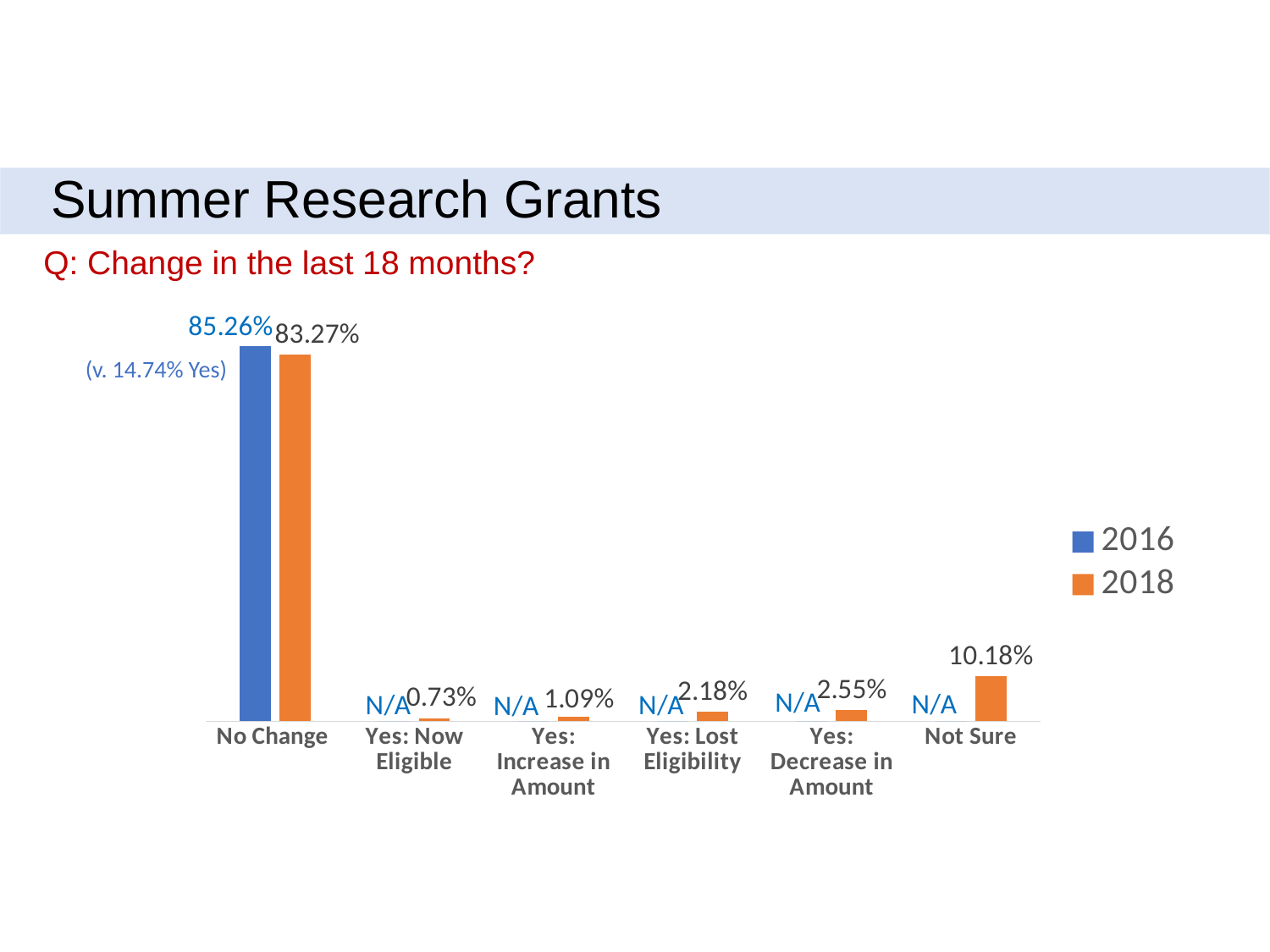
What is the 2018 value for Yes: Now Eligible? 0.73% Which is larger for No Change, the 2016 value or the 2018 value? 2016 What is the difference between the 2016 and 2018 values for No Change? 1.99% How many series does the legend list? 2 What is the 2018 value for Not Sure? 10.18% Which category has the highest 2018 value? No Change Which category has the lowest 2018 value? Yes: Now Eligible What is the 2018 value for No Change? 83.27% What is the 2018 value for Yes: Lost Eligibility? 2.18% What is the 2016 value for No Change? 85.26% What kind of chart is shown on the slide? Bar chart How many categories are shown on the x axis? 6